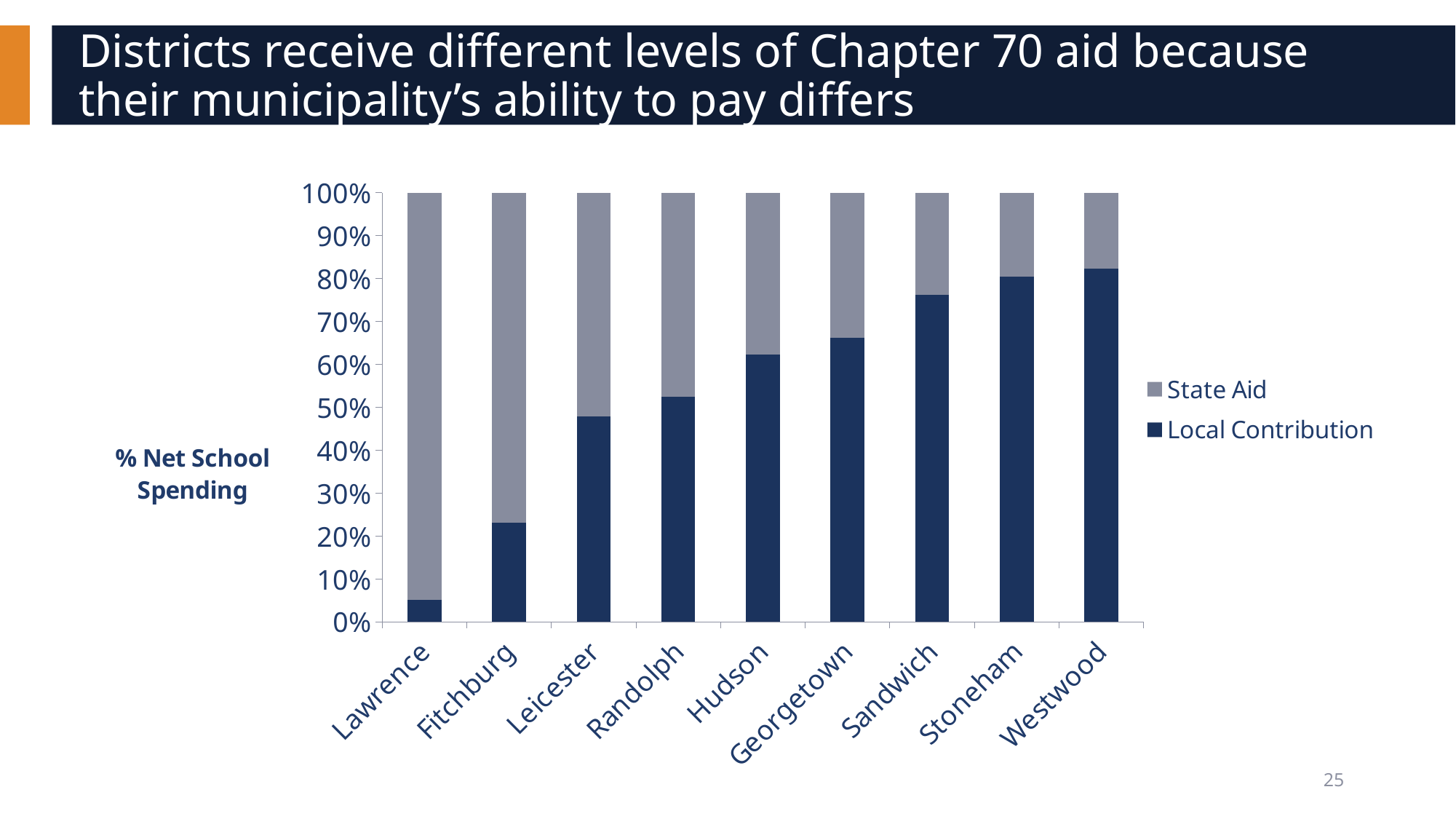
What kind of chart is shown on the slide? Stacked bar chart Is the Local Contribution value for Hudson greater or less than 60%? greater What is the label on the vertical axis of the chart? % Net School Spending How many series does the chart's legend list? 2 Does the Local Contribution share rise or fall moving from Lawrence to Westwood along the x axis? Rises Which has the larger Local Contribution share, Fitchburg or Leicester? Leicester Is the Local Contribution value for Lawrence greater or less than 10%? less Which district has the highest State Aid share? Lawrence Is the Local Contribution value for Fitchburg greater or less than 30%? less Which district has the lowest Local Contribution share? Lawrence How many districts are shown on the x axis of the chart? 9